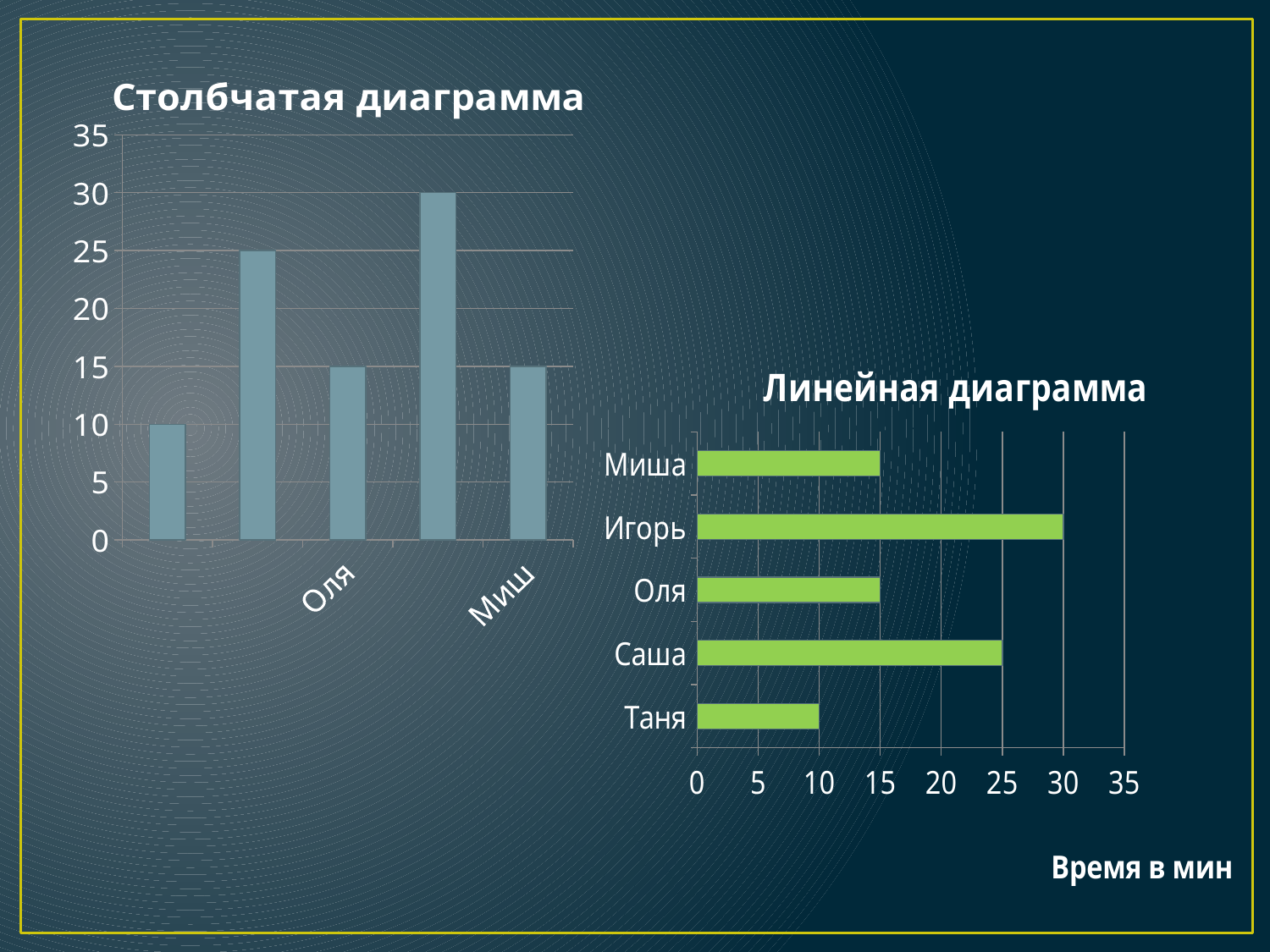
In the chart titled "Линейная диаграмма", what is the value for Саша? 25 What is the axis label text shown below the chart titled "Линейная диаграмма"? Время в мин What kind of chart is the one titled "Линейная диаграмма"? Bar chart In the chart titled "Столбчатая диаграмма", what is the value of the tallest bar? 30 In the chart titled "Линейная диаграмма", what is the value for Таня? 10 In the chart titled "Линейная диаграмма", which is larger, the value for Миша or the value for Таня? Миша In the chart titled "Линейная диаграмма", how many categories are shown? 5 In the chart titled "Столбчатая диаграмма", how many bars are shown? 5 In the chart titled "Линейная диаграмма", what is the value for Игорь? 30 In the chart titled "Линейная диаграмма", what is the difference between the values for Игорь and Саша? 5 In the chart titled "Линейная диаграмма", which category has the lowest value? Таня In the chart titled "Линейная диаграмма", which category has the highest value? Игорь